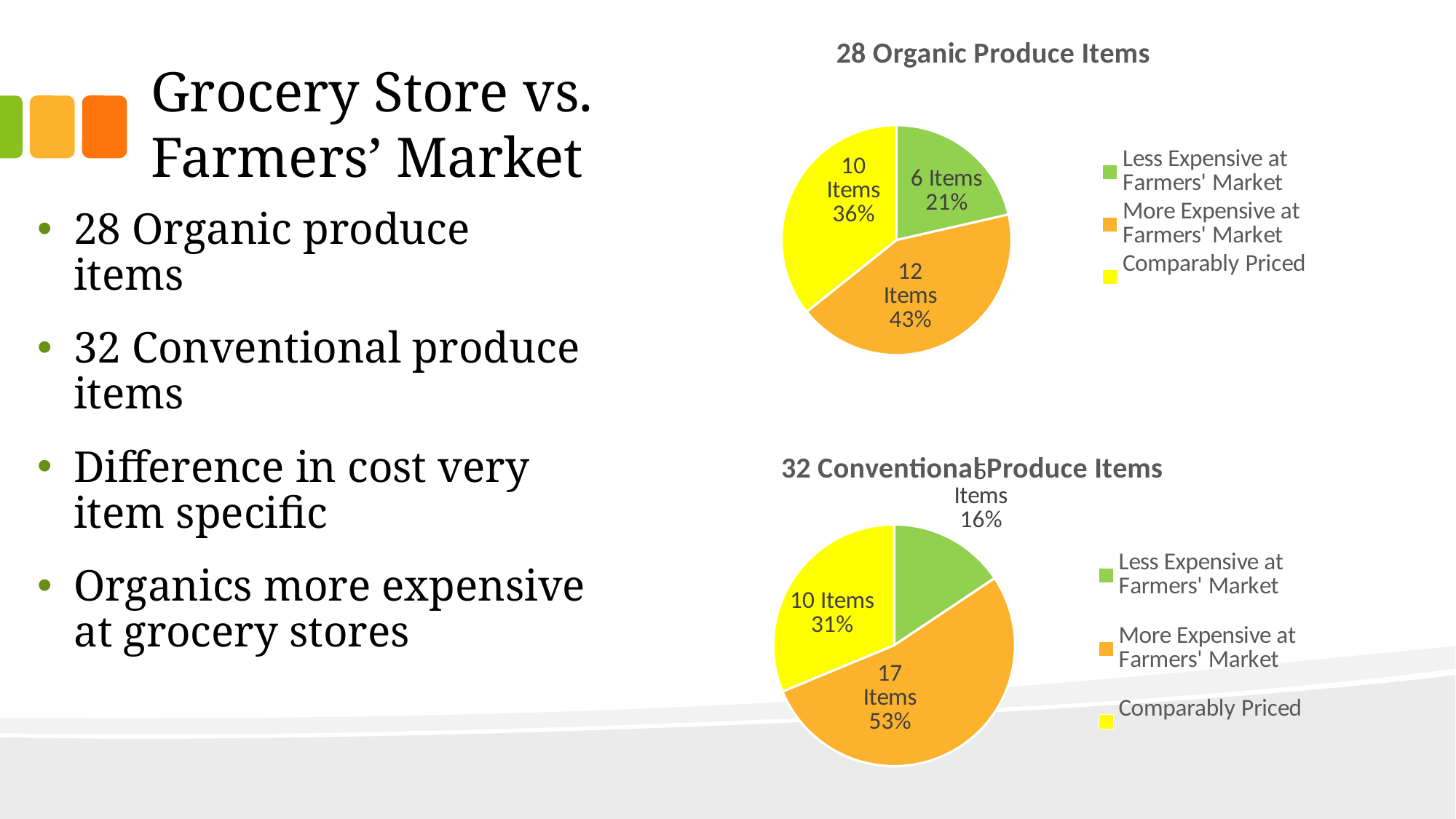
In the '28 Organic Produce Items' pie chart, how many more items are More Expensive at Farmers' Market than Less Expensive at Farmers' Market? 6 In the '28 Organic Produce Items' pie chart, what percentage of items are More Expensive at Farmers' Market? 43% How many categories does the legend of the '32 Conventional Produce Items' chart list? 3 In the '32 Conventional Produce Items' pie chart, which category has the largest share? More Expensive at Farmers' Market In the '32 Conventional Produce Items' pie chart, how many items are Comparably Priced? 10 Items In the '28 Organic Produce Items' pie chart, which category has the largest share? More Expensive at Farmers' Market In the '32 Conventional Produce Items' pie chart, what percentage of items are More Expensive at Farmers' Market? 53% What type of chart is used for the '28 Organic Produce Items' data? Pie chart In the '28 Organic Produce Items' pie chart, which category has the smallest share? Less Expensive at Farmers' Market In the '28 Organic Produce Items' pie chart, how many items are Less Expensive at Farmers' Market? 6 Items In the '28 Organic Produce Items' pie chart, how many items are Comparably Priced? 10 Items In the '32 Conventional Produce Items' pie chart, what percentage of items are Less Expensive at Farmers' Market? 16%